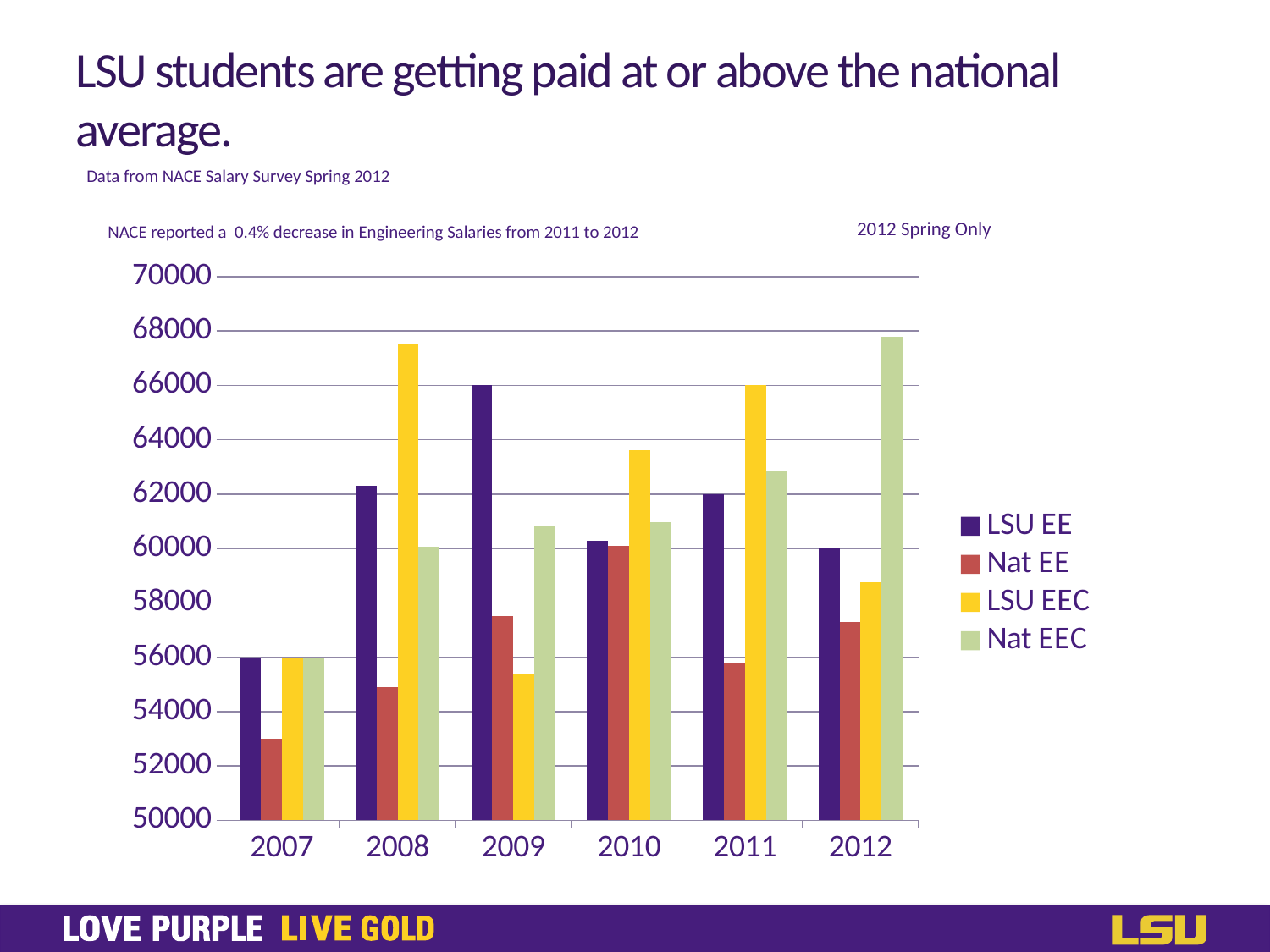
In which year is the Nat EE value lowest? 2007 What kind of chart is shown on the slide? bar chart In which year is the LSU EE value highest? 2009 In which year is the Nat EEC value highest? 2012 What is the LSU EE value for 2009? 66000 Is the LSU EEC value for 2008 greater or less than 66000? greater How many years are shown on the x axis? 6 In 2012, which is larger: LSU EEC or Nat EEC? Nat EEC How many series does the legend list? 4 Is the Nat EE value for 2007 greater or less than 54000? less Which series is shown in yellow in the legend? LSU EEC What is the LSU EEC value for 2011? 66000